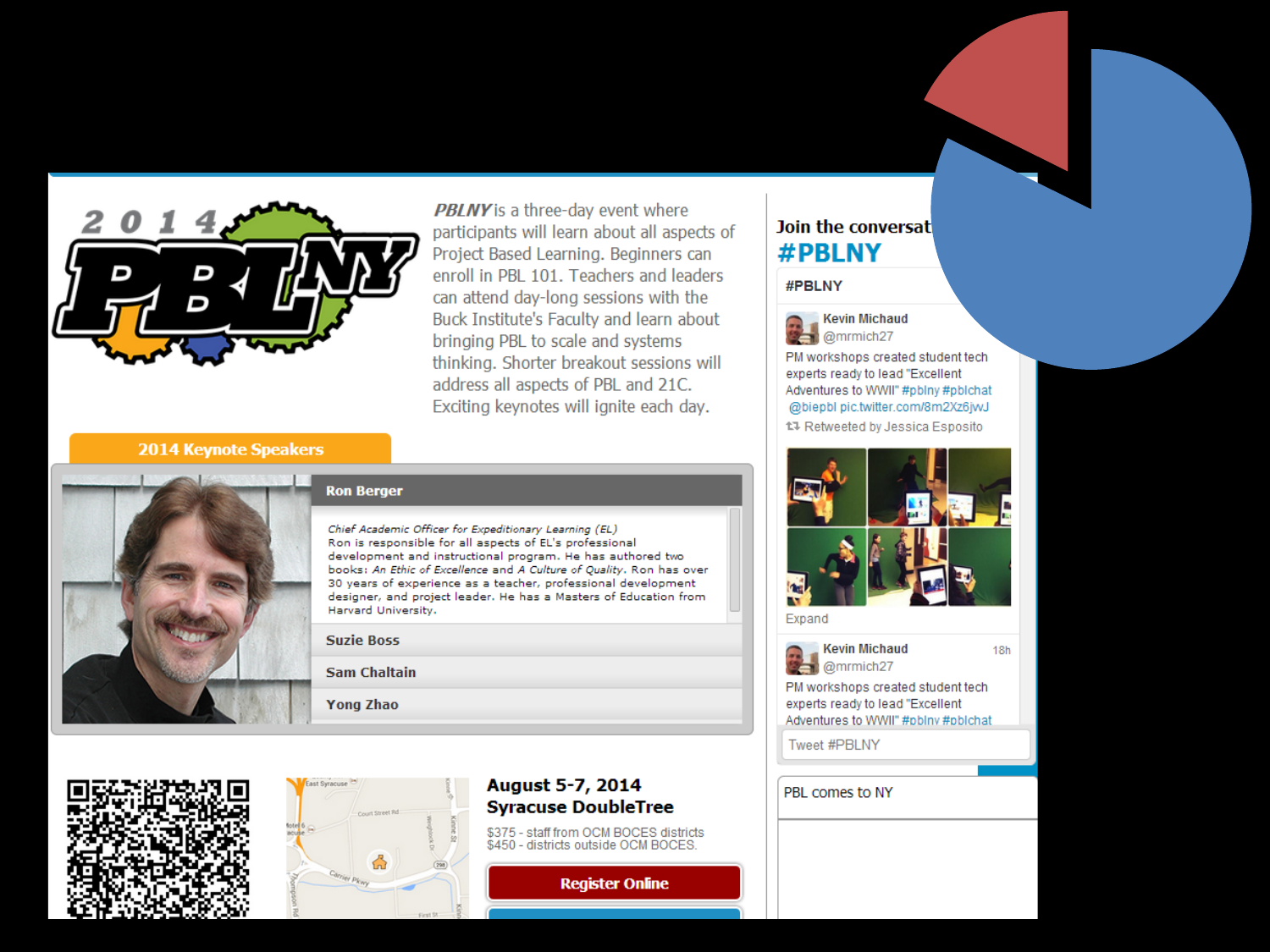
Which slice of the pie chart is pulled out (exploded) from the rest? the red slice How many slices does the pie chart have? 2 What kind of chart is shown in the top right corner of the slide? pie chart Which colour slice is the smallest in the pie chart? red Which slice of the pie chart is larger, the blue one or the red one? blue Which colour slice is the largest in the pie chart? blue Is the red slice of the pie chart more or less than half of the pie? less Does the pie chart display a legend? No